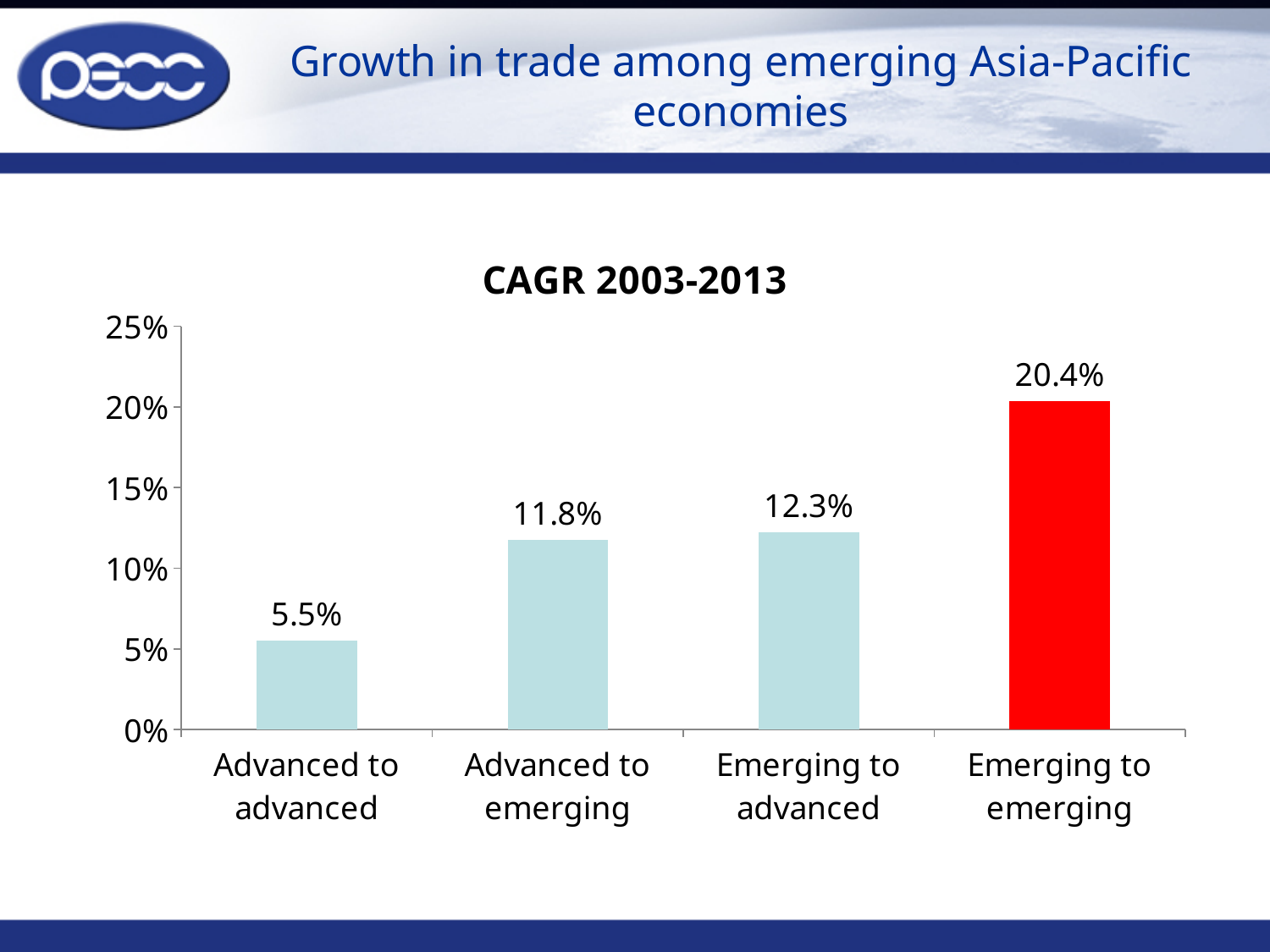
What kind of chart is shown on the slide? Bar chart Which category has the highest CAGR 2003-2013? Emerging to emerging How many categories are shown in the chart? 4 What is the difference between the CAGR for Emerging to advanced and Advanced to emerging? 0.5% What is the difference between the CAGR for Emerging to emerging and Advanced to advanced? 14.9% What is the title of the chart? CAGR 2003-2013 What is the CAGR 2003-2013 value for Advanced to emerging? 11.8% What is the CAGR 2003-2013 value for Advanced to advanced? 5.5% What is the CAGR 2003-2013 value for Emerging to advanced? 12.3% Which category has the lowest CAGR 2003-2013? Advanced to advanced What is the CAGR 2003-2013 value for Emerging to emerging? 20.4% Which is larger, the CAGR for Emerging to advanced or Advanced to emerging? Emerging to advanced